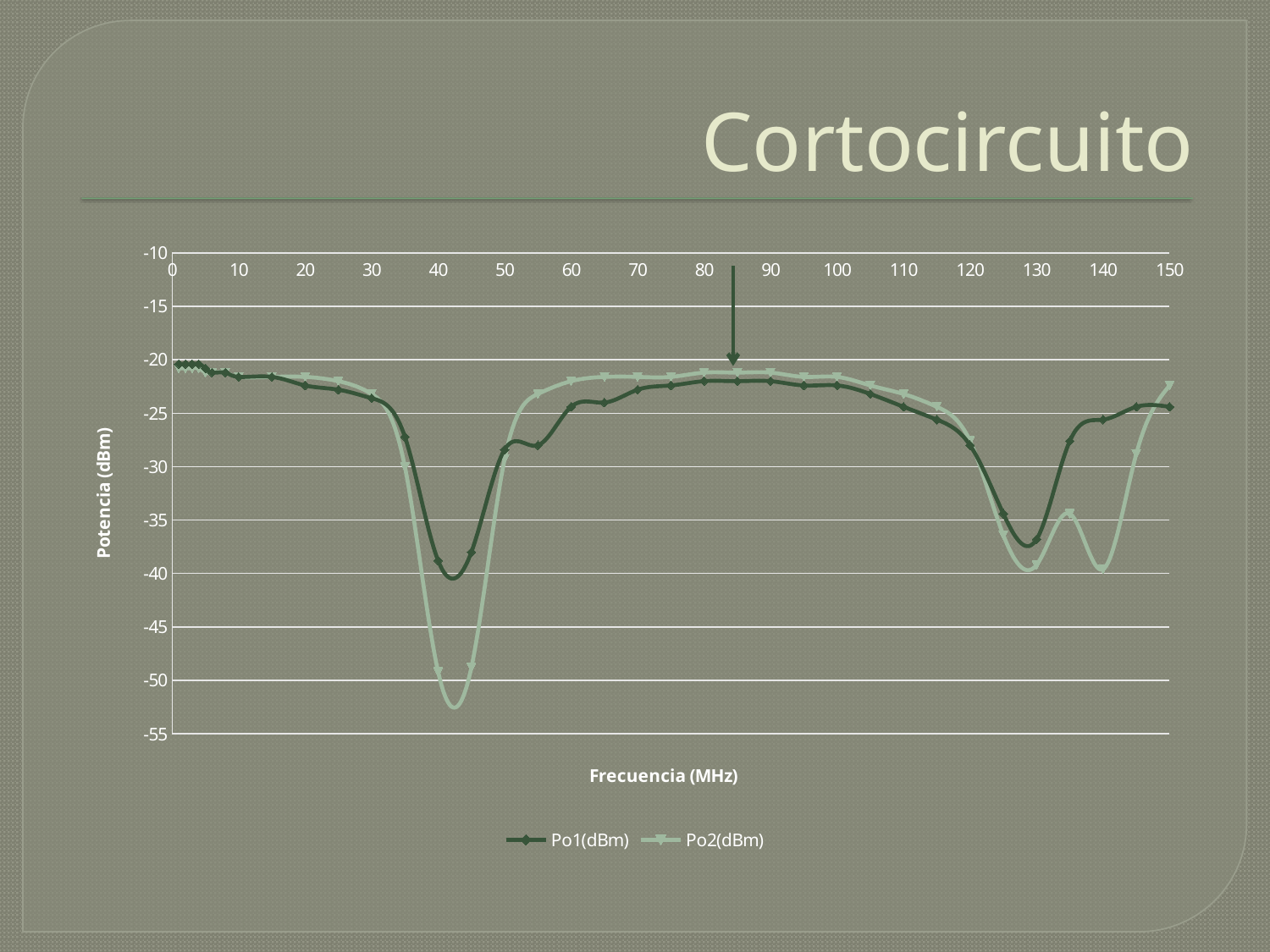
Is the value of Po1(dBm) at 80 MHz greater or less than -25? greater What kind of chart is shown on the slide? line chart How many series does the legend list? 2 Is the value of Po1(dBm) at 130 MHz greater or less than -30? less Is the value of Po2(dBm) at 40 MHz greater or less than -45? less Which series reaches the lowest value anywhere on the chart? Po2(dBm) What is the title of the chart? Cortocircuito What is the label of the x axis? Frecuencia (MHz) At 140 MHz, which series has the higher value, Po1(dBm) or Po2(dBm)? Po1(dBm) At 40 MHz, which series has the higher value, Po1(dBm) or Po2(dBm)? Po1(dBm)